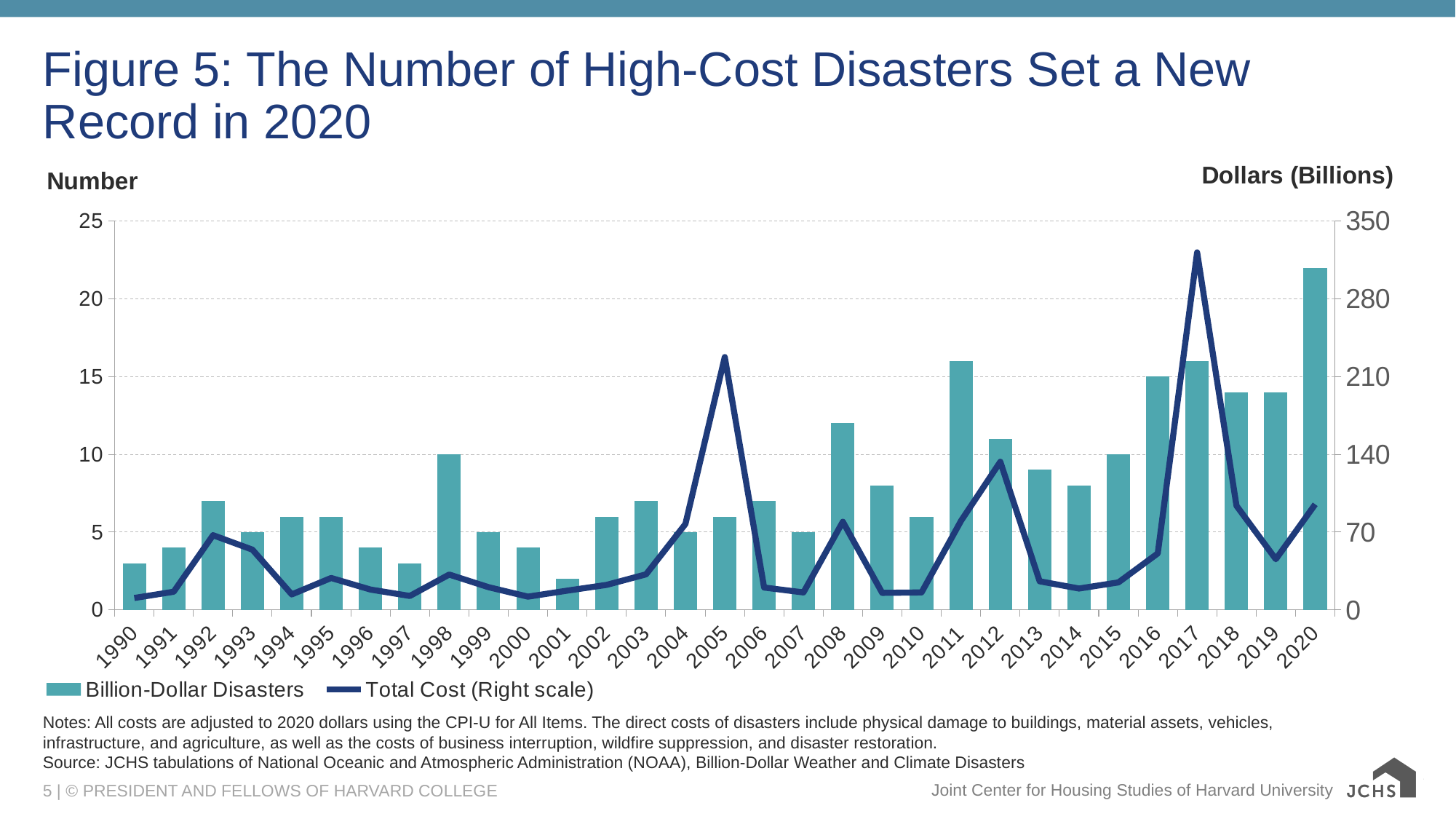
Is the number of Billion-Dollar Disasters in 2020 greater or less than 20? greater How many series does the legend list? 2 Overall, does the number of Billion-Dollar Disasters rise or fall from 1990 to 2020? rise How many Billion-Dollar Disasters were there in 2015? 10 In which year does the Total Cost line reach its peak? 2017 What type of chart is shown on the slide? Combination bar and line chart How many years are shown on the x axis? 31 Is the Total Cost in 2017 greater or less than 280 billion dollars? greater Which year had more Billion-Dollar Disasters, 2017 or 2020? 2020 Which year has the lowest number of Billion-Dollar Disasters? 2001 Which year has the highest number of Billion-Dollar Disasters? 2020 How many Billion-Dollar Disasters were there in 1998? 10